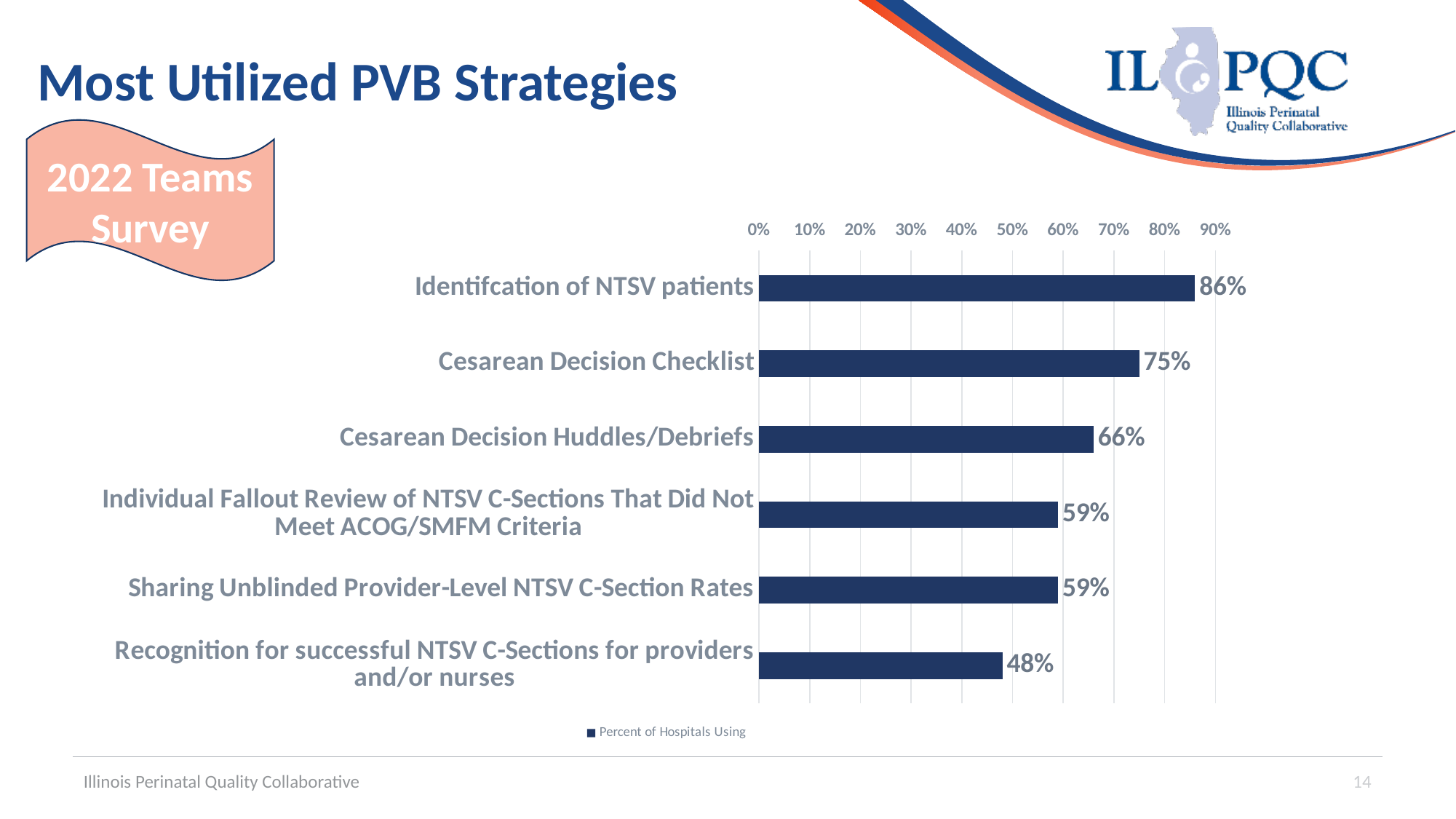
Which strategy has the lowest percent of hospitals using it? Recognition for successful NTSV C-Sections for providers and/or nurses What percent of hospitals use Recognition for successful NTSV C-Sections for providers and/or nurses? 48% Which strategy has the highest percent of hospitals using it? Identifcation of NTSV patients What kind of chart is shown on the slide? Bar chart What percent of hospitals use Identifcation of NTSV patients? 86% What is the difference between the values for Cesarean Decision Huddles/Debriefs and Recognition for successful NTSV C-Sections for providers and/or nurses? 18% Which is larger, the value for Cesarean Decision Huddles/Debriefs or the value for Sharing Unblinded Provider-Level NTSV C-Section Rates? Cesarean Decision Huddles/Debriefs Is the value for Cesarean Decision Checklist greater or less than 70%? greater How many series does the legend list? 1 What is the difference between the values for Identifcation of NTSV patients and Cesarean Decision Checklist? 11% How many strategies are shown in the chart? 6 What is the value for Cesarean Decision Checklist? 75%